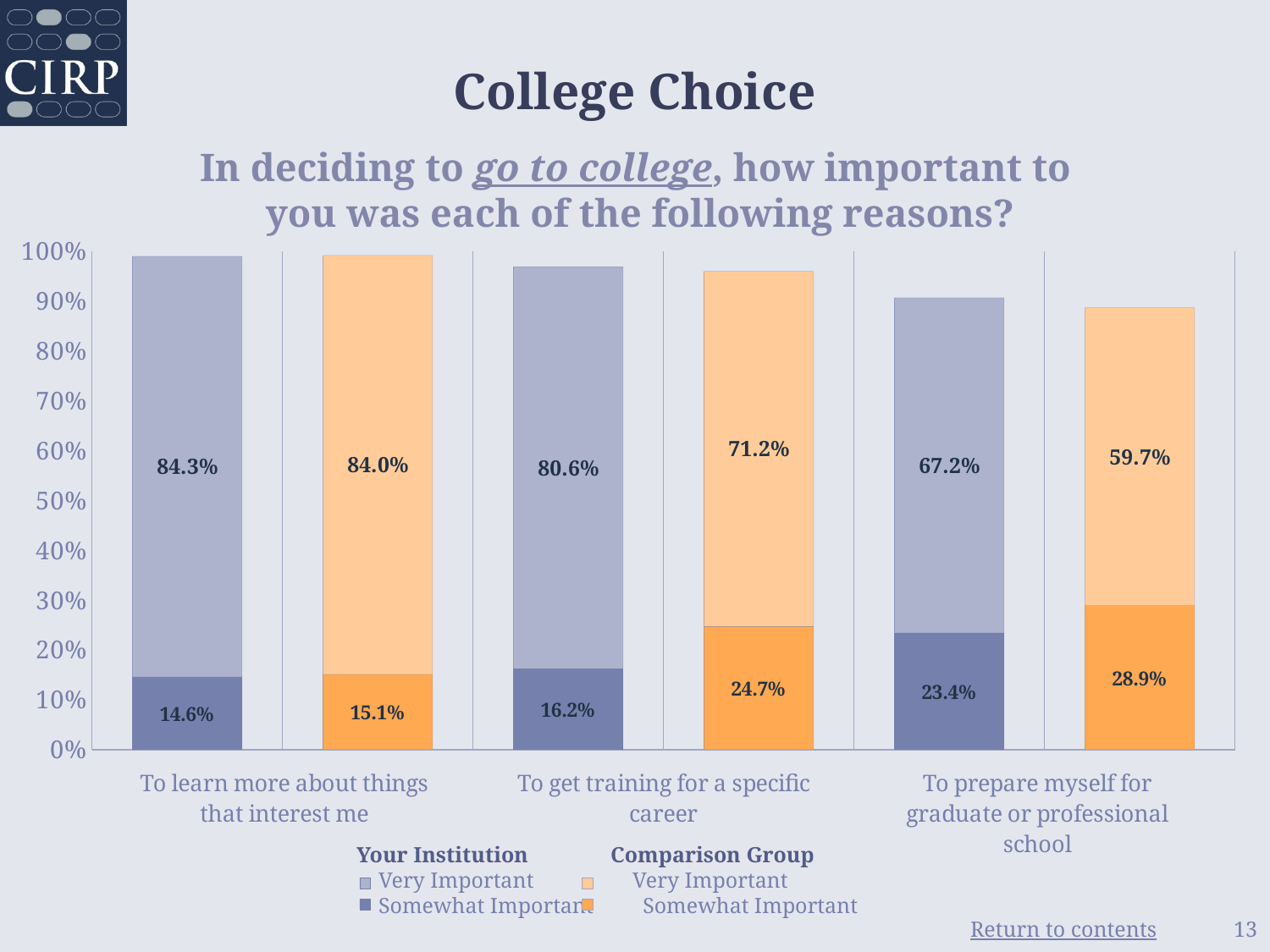
What is the combined Very Important and Somewhat Important total for the Comparison Group on "To prepare myself for graduate or professional school"? 88.6% Which reason has the highest Somewhat Important percentage for Your Institution? To prepare myself for graduate or professional school For "To prepare myself for graduate or professional school", which group has the larger Somewhat Important percentage, Your Institution or the Comparison Group? Comparison Group What percentage of Your Institution students rated "To prepare myself for graduate or professional school" as Very Important? 67.2% What is the difference between the Your Institution and Comparison Group Very Important percentages for "To get training for a specific career"? 9.4% What is the combined Very Important and Somewhat Important total for Your Institution on "To get training for a specific career"? 96.8% What type of chart is shown on the slide? Stacked bar chart What percentage of the Comparison Group rated "To get training for a specific career" as Somewhat Important? 24.7% How many series does the chart legend list? 4 How many reasons (categories) are shown on the x axis of the chart? 3 What percentage of Your Institution students rated "To learn more about things that interest me" as Very Important? 84.3% Which reason has the lowest Very Important percentage for the Comparison Group? To prepare myself for graduate or professional school